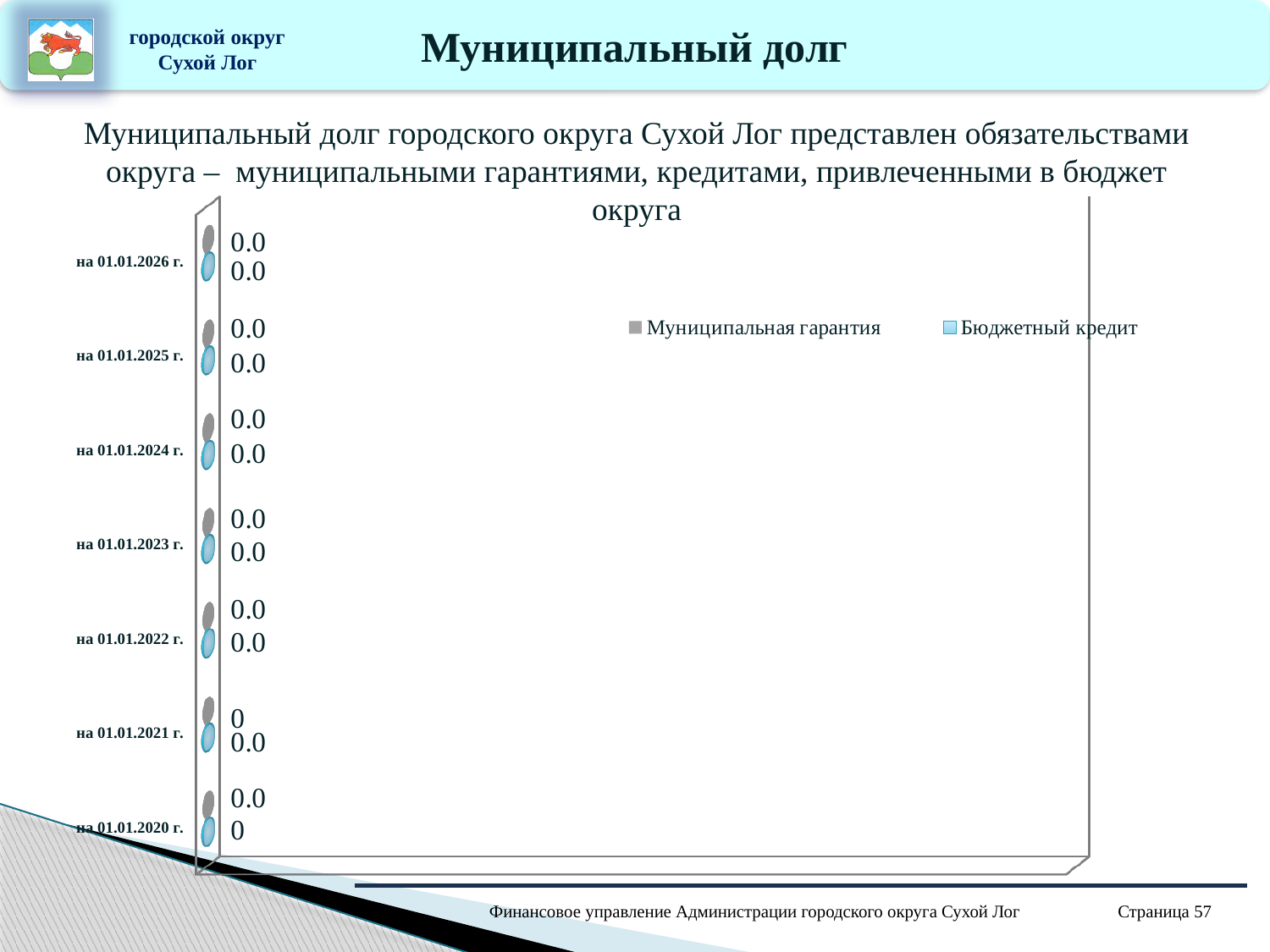
What is the value of Бюджетный кредит for на 01.01.2020 г.? 0 What is the value of Муниципальная гарантия for на 01.01.2021 г.? 0 How many series does the chart legend list? 2 Which series is shown in gray in the legend? Муниципальная гарантия What is the difference between Муниципальная гарантия and Бюджетный кредит for на 01.01.2024 г.? 0.0 Which series is shown in light blue in the legend? Бюджетный кредит What kind of chart is shown on the slide? bar chart What is the value of Бюджетный кредит for на 01.01.2025 г.? 0.0 How many date categories are shown on the chart? 7 What is the value of Бюджетный кредит for на 01.01.2023 г.? 0.0 Do the values of Муниципальная гарантия rise, fall or stay the same from на 01.01.2020 г. to на 01.01.2026 г.? stay the same What is the value of Муниципальная гарантия for на 01.01.2026 г.? 0.0